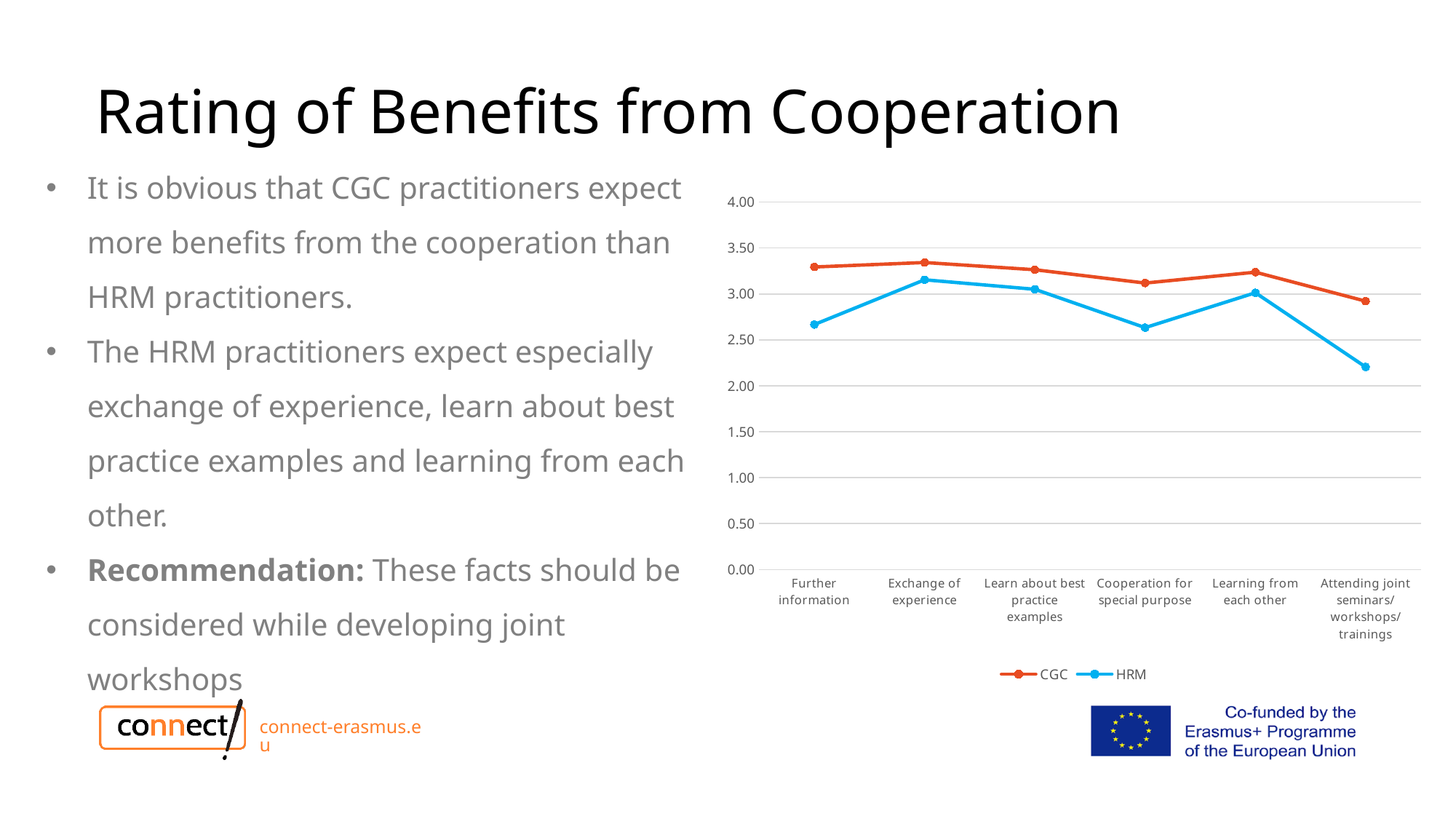
Which category has the lowest HRM value? Attending joint seminars/workshops/trainings Is the HRM value for Exchange of experience greater or less than 3.00? greater Is the CGC value for Further information greater or less than 3.00? greater How many categories are plotted along the x axis of the chart? 6 Which category has the highest HRM value? Exchange of experience Which category has the lowest CGC value? Attending joint seminars/workshops/trainings What kind of chart is shown on the slide? line chart Which series is drawn with the blue line in the chart? HRM Is the HRM value for Attending joint seminars/workshops/trainings greater or less than 2.50? less Does the HRM line rise or fall from Learning from each other to Attending joint seminars/workshops/trainings? fall Which series has the larger value for Further information, CGC or HRM? CGC How many series does the chart legend list? 2